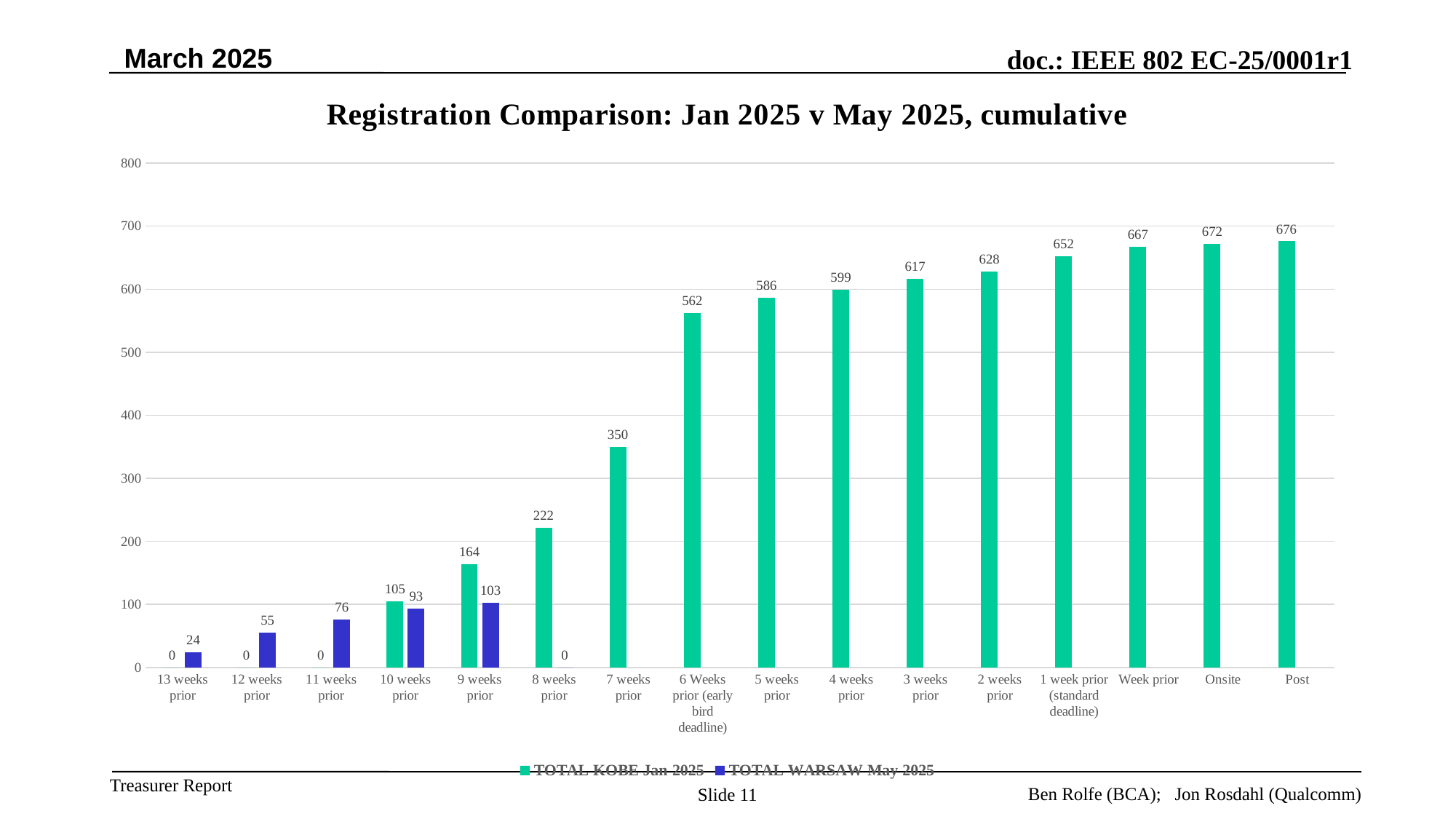
What is the difference between the TOTAL KOBE Jan 2025 and TOTAL WARSAW May 2025 values at 9 weeks prior? 61 At 10 weeks prior, which series has the larger value, TOTAL KOBE Jan 2025 or TOTAL WARSAW May 2025? TOTAL KOBE Jan 2025 What kind of chart is shown on the slide? bar chart How many categories are shown on the x axis? 16 What is the TOTAL WARSAW May 2025 value at 11 weeks prior? 76 Which category has the highest TOTAL WARSAW May 2025 value? 9 weeks prior How many series does the legend list? 2 Is the TOTAL KOBE Jan 2025 value at 6 Weeks prior (early bird deadline) greater or less than 500? greater Do the TOTAL KOBE Jan 2025 values rise or fall from 10 weeks prior to Post? rise What is the TOTAL KOBE Jan 2025 value at 7 weeks prior? 350 Which category has the highest TOTAL KOBE Jan 2025 value? Post What is the TOTAL KOBE Jan 2025 value at Post? 676